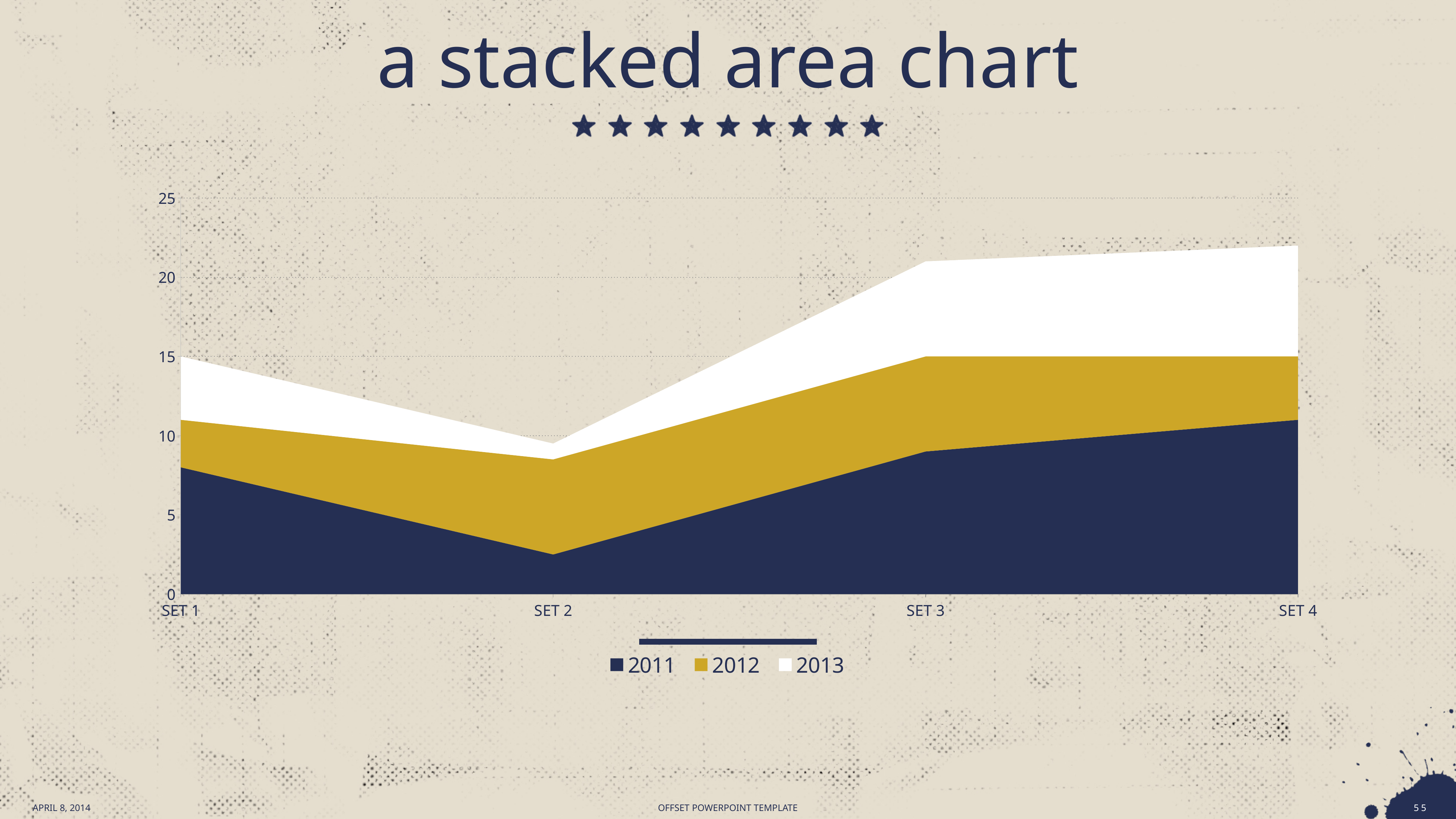
How many series does the legend list? 3 Which category has the highest value for the 2011 series? SET 4 How many categories are shown on the x axis? 4 Is the value for 2011 at SET 4 greater or less than 10? greater Is the stacked total at SET 3 greater or less than 20? greater Does the 2011 series rise or fall from SET 2 to SET 4? rise Which category has the lowest stacked total? SET 2 Is the stacked total at SET 1 greater or less than 20? less What kind of chart is shown on the slide? stacked area chart Which category has the lowest value for the 2011 series? SET 2 Which series is shown in white? 2013